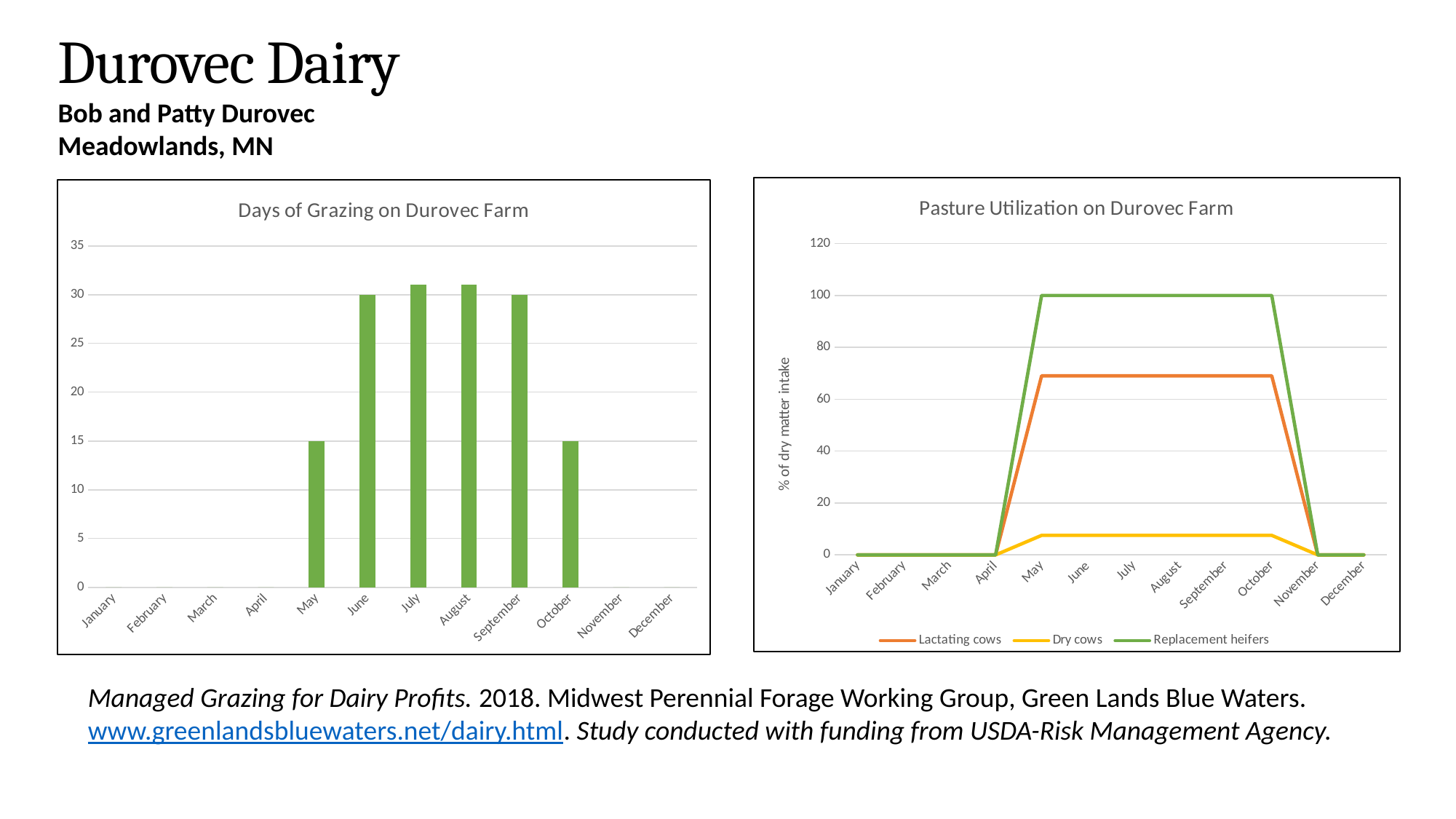
In the 'Days of Grazing on Durovec Farm' chart, how many days of grazing are shown for January? 0 What type of chart is 'Days of Grazing on Durovec Farm'? bar chart How many months are shown on the x axis of the 'Days of Grazing on Durovec Farm' chart? 12 In the 'Pasture Utilization on Durovec Farm' chart, is the value for Lactating cows in June greater or less than 60? greater In the 'Days of Grazing on Durovec Farm' chart, is the value for July greater or less than 35? less In the 'Pasture Utilization on Durovec Farm' chart, what is the value for Replacement heifers in July? 100 In the 'Days of Grazing on Durovec Farm' chart, which month has more days of grazing, May or June? June In the 'Days of Grazing on Durovec Farm' chart, how many days of grazing are shown for June? 30 What type of chart is 'Pasture Utilization on Durovec Farm'? line chart How many series does the legend of the 'Pasture Utilization on Durovec Farm' chart list? 3 In the 'Days of Grazing on Durovec Farm' chart, how many days of grazing are shown for May? 15 In the 'Days of Grazing on Durovec Farm' chart, how many days of grazing are shown for October? 15